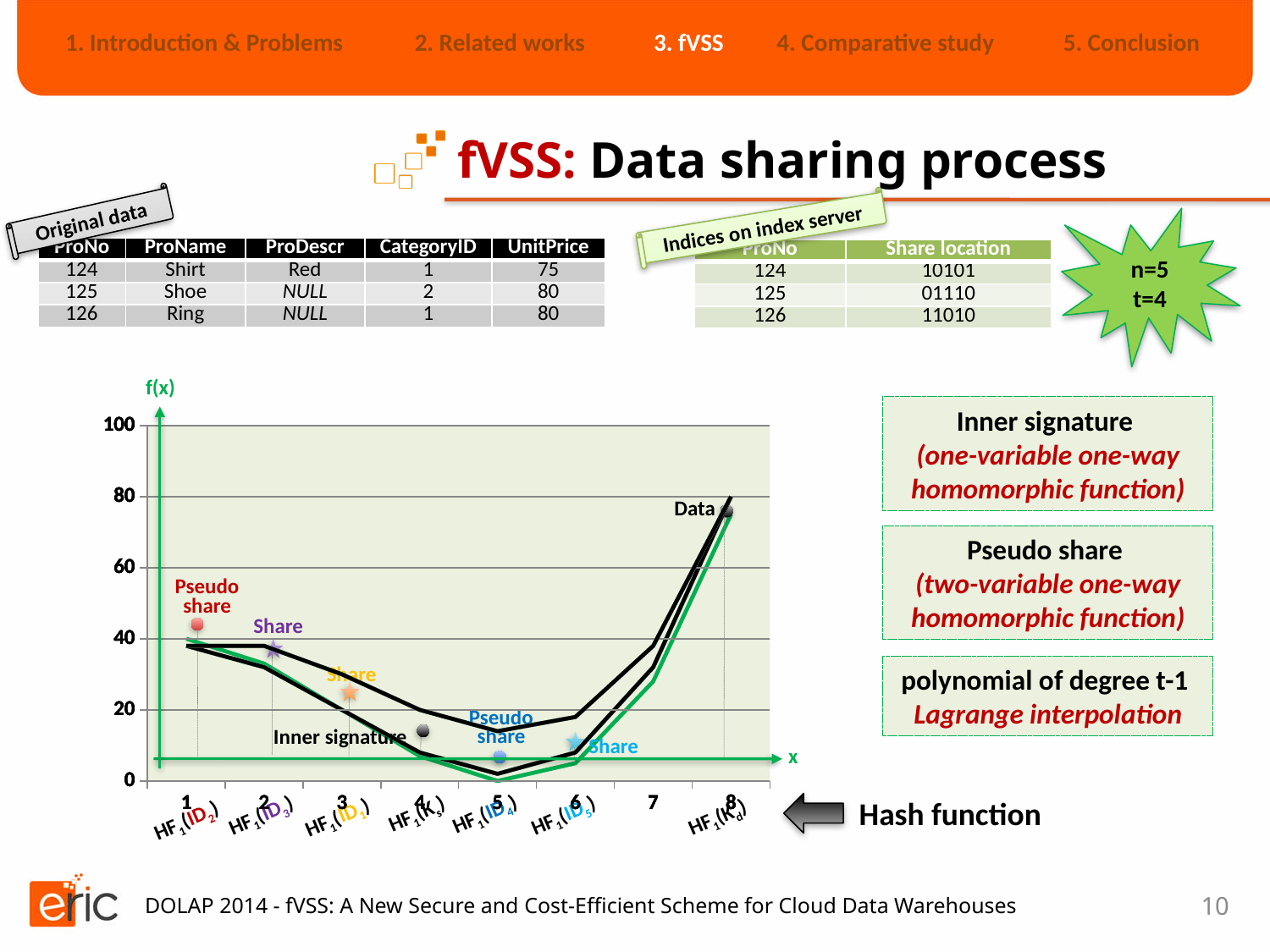
What kind of chart is shown on the slide? line chart How many numbered positions are marked along the x axis of the chart? 8 Which has the larger f(x) value: the Data point at x = 8 or the Pseudo share point at x = 1? Data Is the f(x) value of the point labelled Inner signature (at x = 4) greater or less than 20? less Is the f(x) value of the Pseudo share point at x = 5 greater or less than 20? less What is the label of the vertical axis of the chart? f(x) Between x = 1 and x = 5, do the plotted f(x) values rise or fall? fall What is the highest tick value shown on the vertical axis of the chart? 100 Is the f(x) value of the point labelled Data greater or less than 60? greater Which labelled point on the chart has the highest f(x) value? Data